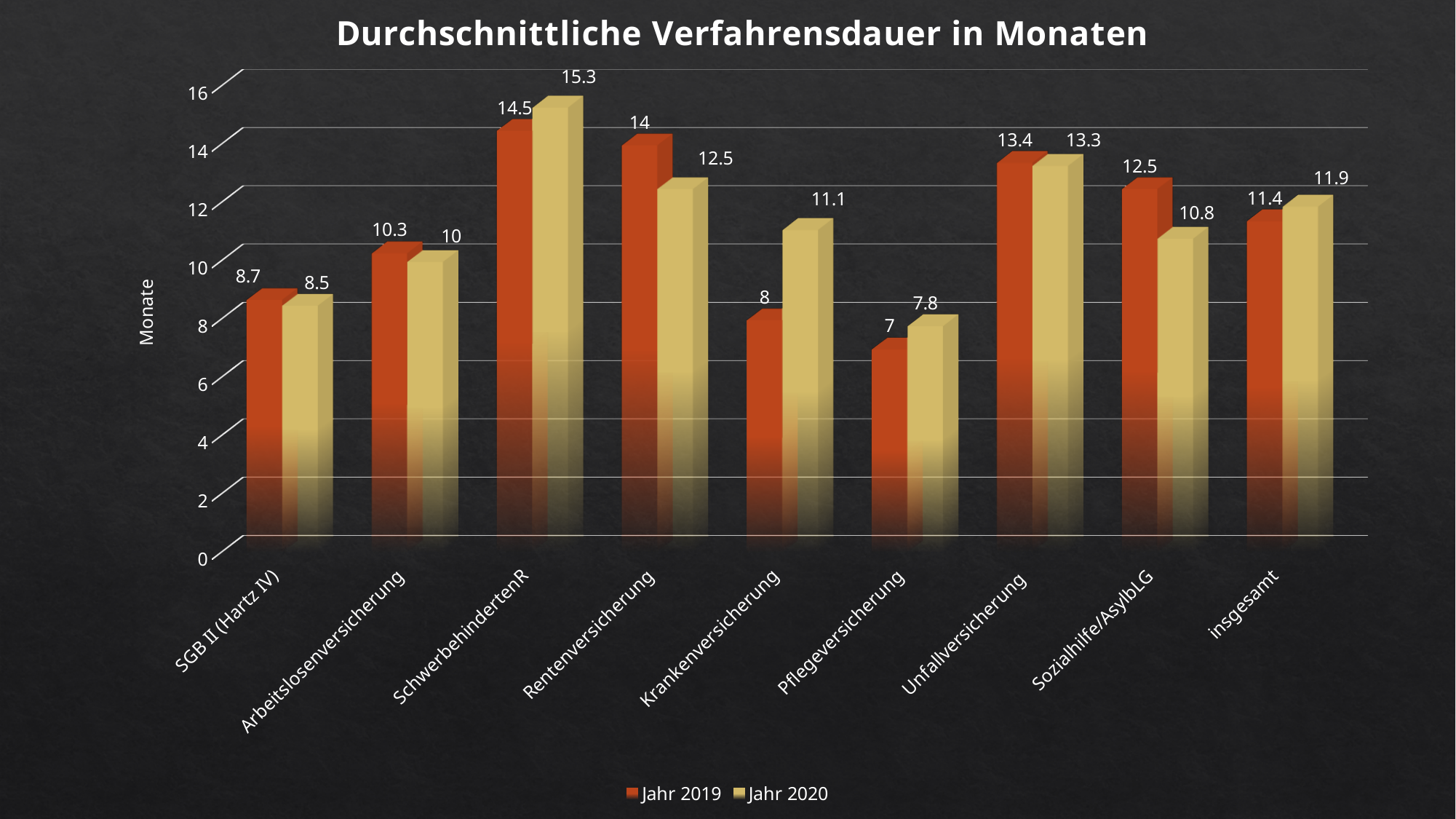
Which category has the lowest Jahr 2020 value? Pflegeversicherung How many series does the legend list? 2 Which is larger for Krankenversicherung, the Jahr 2019 value or the Jahr 2020 value? Jahr 2020 Which category has the highest Jahr 2019 value? SchwerbehindertenR What is the value for Jahr 2020 for SchwerbehindertenR? 15.3 What is the difference between the Jahr 2019 and Jahr 2020 values for Sozialhilfe/AsylbLG? 1.7 How many categories are shown on the x axis? 9 What kind of chart is shown on the slide? Bar chart What is the title of the chart? Durchschnittliche Verfahrensdauer in Monaten What is the value for Jahr 2019 for Pflegeversicherung? 7 What is the label of the vertical axis? Monate What is the value for Jahr 2020 for insgesamt? 11.9